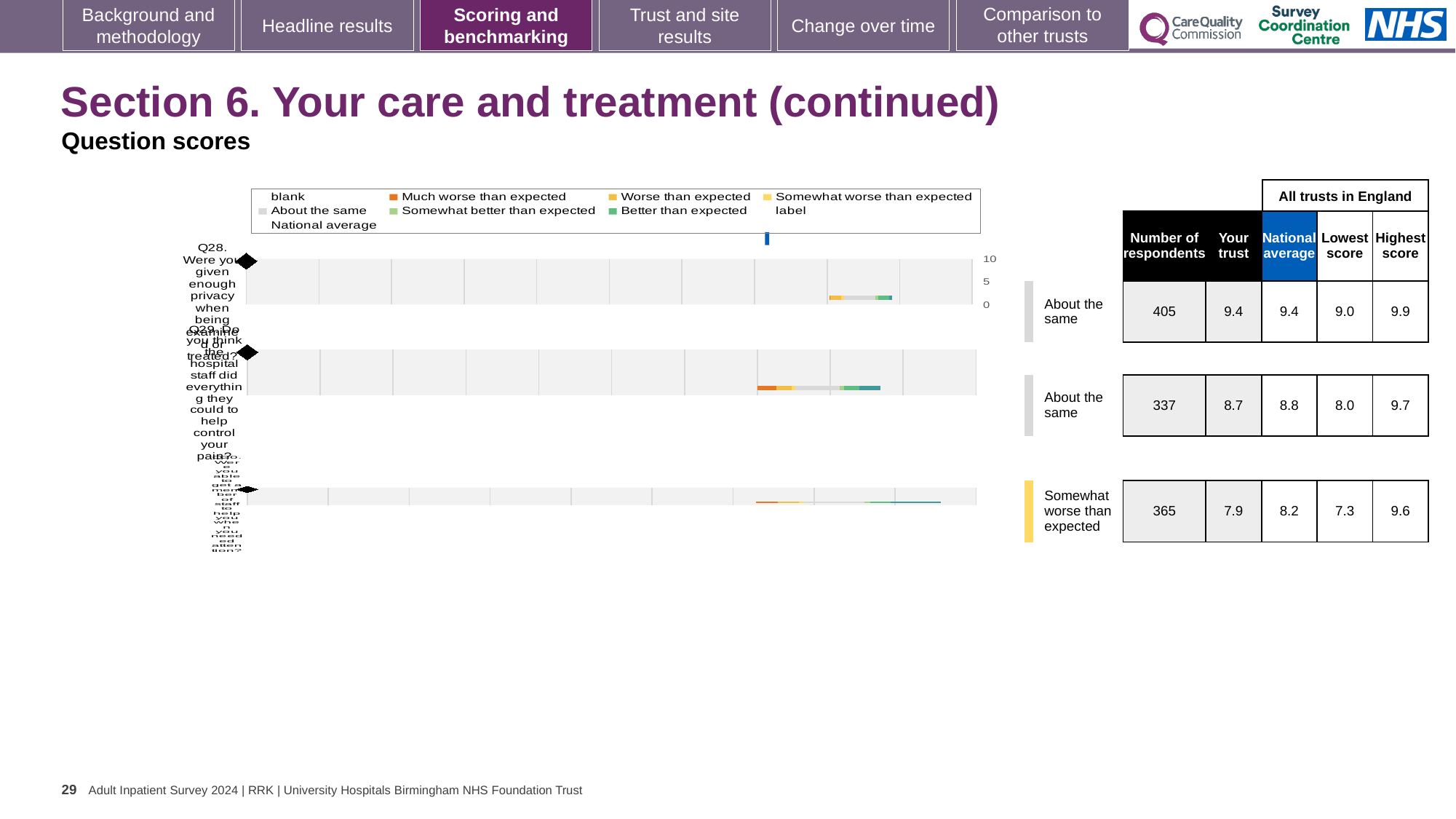
Which question has the highest number of respondents? Q28 What is the lowest score among all trusts in England for Q29? 8.0 What is the national average score for Q30? 8.2 What benchmark category is shown for Q30? Somewhat worse than expected What is the 'Your trust' score for Q29 (staff did everything to help control your pain)? 8.7 What kind of chart is used to show the question scores? Bar chart Which has the higher 'Your trust' score, Q28 or Q29? Q28 What is the highest score among all trusts in England for Q28? 9.9 How many questions are plotted on this slide? 3 Which question has the lowest 'Your trust' score? Q30 What is the difference between the national average and the 'Your trust' score for Q30? 0.3 How many respondents are shown for Q28 (privacy when being examined or treated)? 405